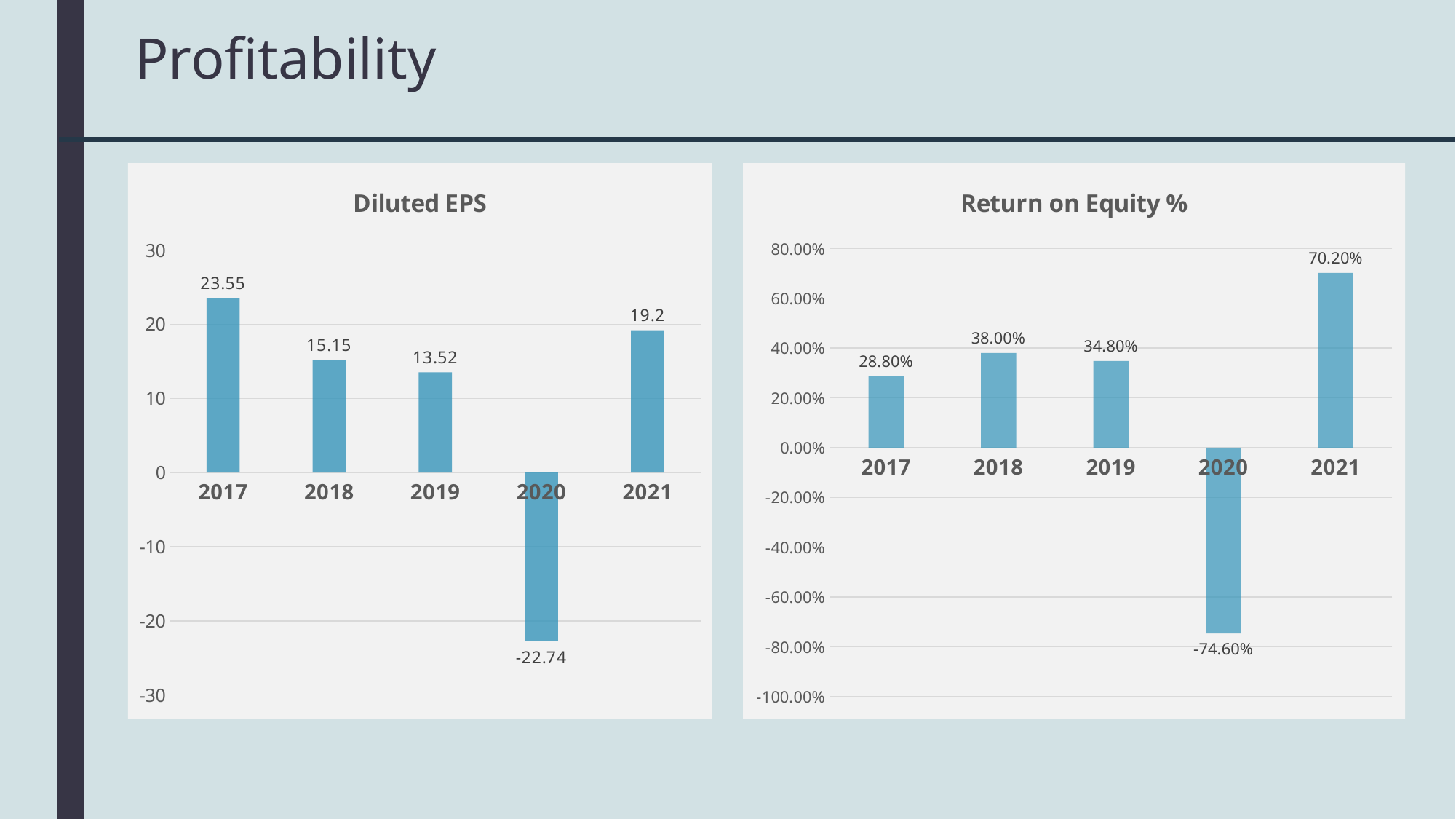
In the Diluted EPS chart, which year has the lowest value? 2020 What kind of chart is the Return on Equity % chart? Bar chart In the Diluted EPS chart, what is the difference between the 2017 and 2021 values? 4.35 In the Diluted EPS chart, how many years are shown on the x axis? 5 In the Return on Equity % chart, which is larger, the value for 2018 or the value for 2019? 2018 In the Return on Equity % chart, which year has the highest value? 2021 In the Return on Equity % chart, what is the difference between the 2018 and 2017 values? 9.20% In the Return on Equity % chart, what is the value for 2020? -74.60% In the Diluted EPS chart, what is the value for 2017? 23.55 In the Diluted EPS chart, which year has the highest value? 2017 In the Return on Equity % chart, what is the value for 2021? 70.20% In the Diluted EPS chart, what is the value for 2020? -22.74